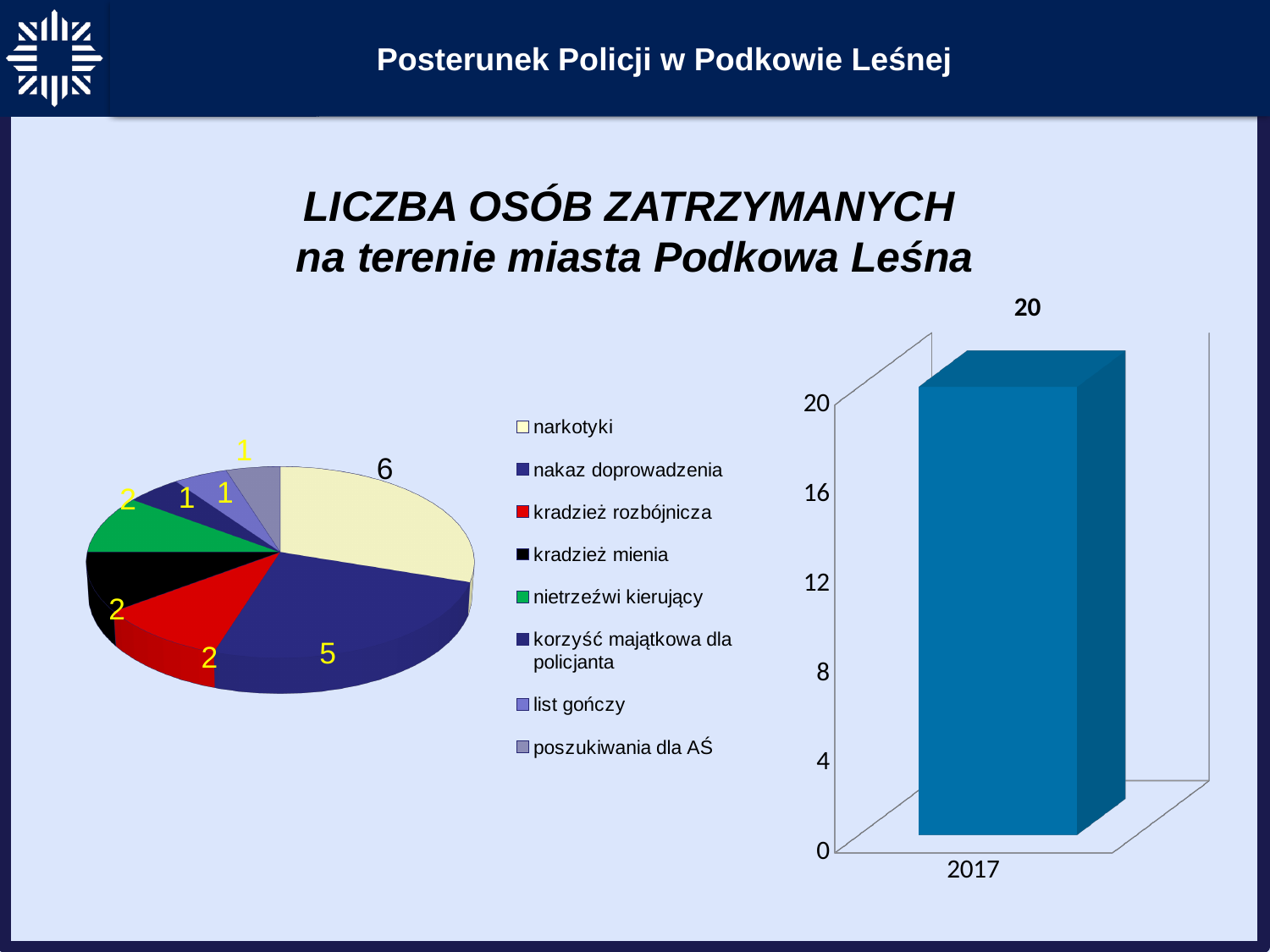
How many bars does the chart on the right show? 1 On the pie chart, what is the value for kradzież rozbójnicza? 2 On the pie chart, what share of the total does narkotyki represent? 30% How many categories does the pie chart's legend list? 8 On the pie chart, which is larger: nietrzeźwi kierujący or list gończy? nietrzeźwi kierujący On the pie chart, what is the value for nakaz doprowadzenia? 5 On the pie chart, which category has the largest slice? narkotyki On the pie chart, what is the value for narkotyki? 6 On the pie chart, what is the difference between the values for narkotyki and nakaz doprowadzenia? 1 On the bar chart on the right, what is the value for 2017? 20 What kind of chart is on the right side of the slide? bar chart What is the title of the slide's charts? LICZBA OSÓB ZATRZYMANYCH na terenie miasta Podkowa Leśna